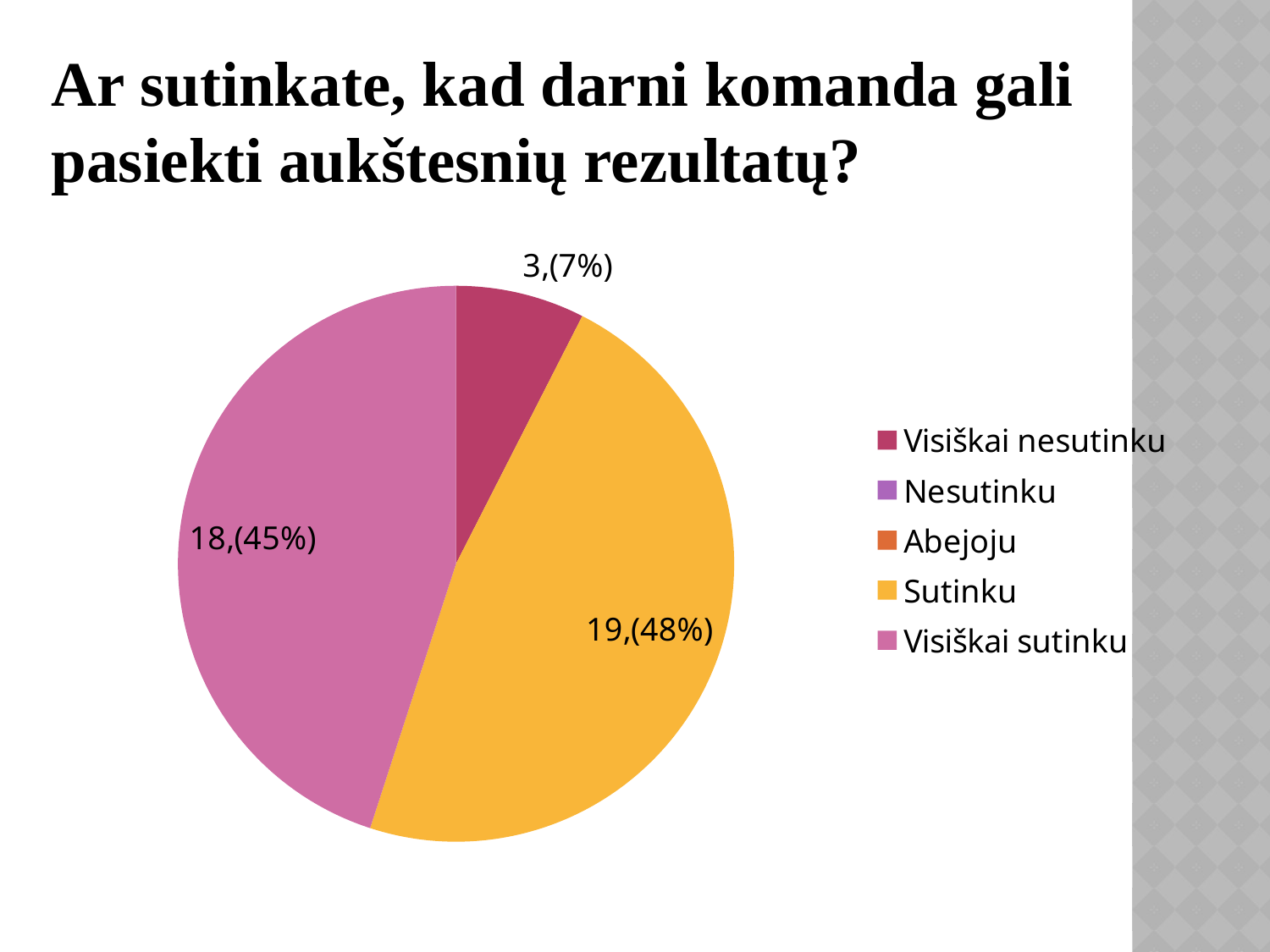
How many entries does the legend list? 5 How many slices are visible in the pie chart? 3 What is the data label for the Visiškai nesutinku slice? 3,(7%) What is the difference in count between the Sutinku and Visiškai sutinku slices? 1 What is the data label for the Visiškai sutinku slice? 18,(45%) Which is larger, the Visiškai nesutinku slice or the Visiškai sutinku slice? Visiškai sutinku What share of the pie does the Visiškai sutinku slice represent? 45% Which category with a visible slice has the smallest share of the pie? Visiškai nesutinku What kind of chart is shown on the slide? pie chart Which category has the largest slice of the pie? Sutinku What is the data label for the Sutinku slice? 19,(48%) What colour is the Sutinku slice? yellow/orange